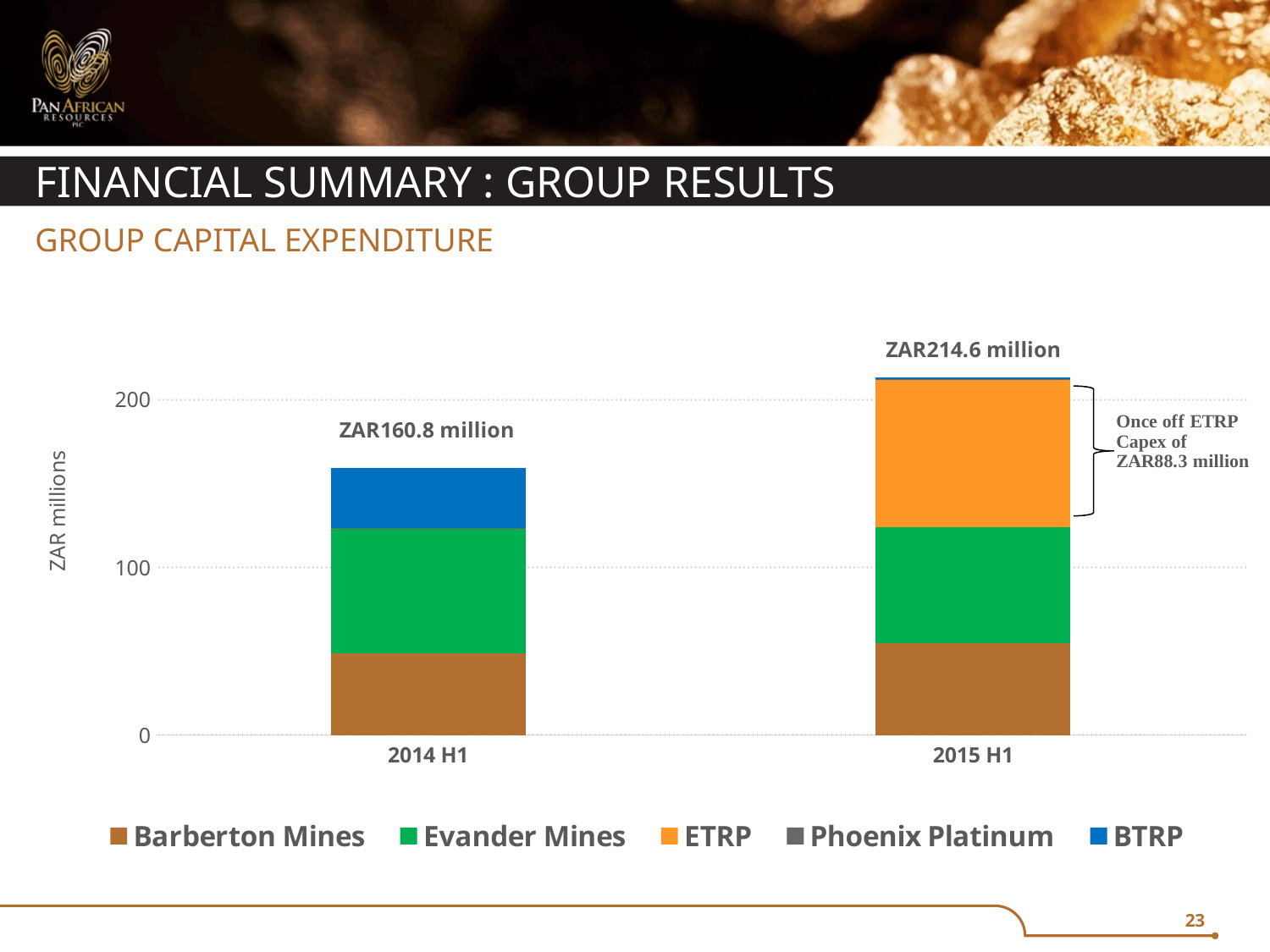
What is the total group capital expenditure shown for 2014 H1? ZAR160.8 million Is the Barberton Mines segment for 2014 H1 greater or less than 100? less What is the total group capital expenditure shown for 2015 H1? ZAR214.6 million What is the once-off ETRP capex amount noted on the chart? ZAR88.3 million Which period has the higher total capital expenditure, 2014 H1 or 2015 H1? 2015 H1 How many series does the legend list? 5 How many periods (categories) are plotted on the x axis? 2 What kind of chart is shown on the slide? Stacked bar chart By how much did total capital expenditure increase from 2014 H1 to 2015 H1? ZAR53.8 million Does total capital expenditure rise or fall from 2014 H1 to 2015 H1? Rise Is the total for 2015 H1 greater or less than 200? greater What is the label on the vertical axis? ZAR millions